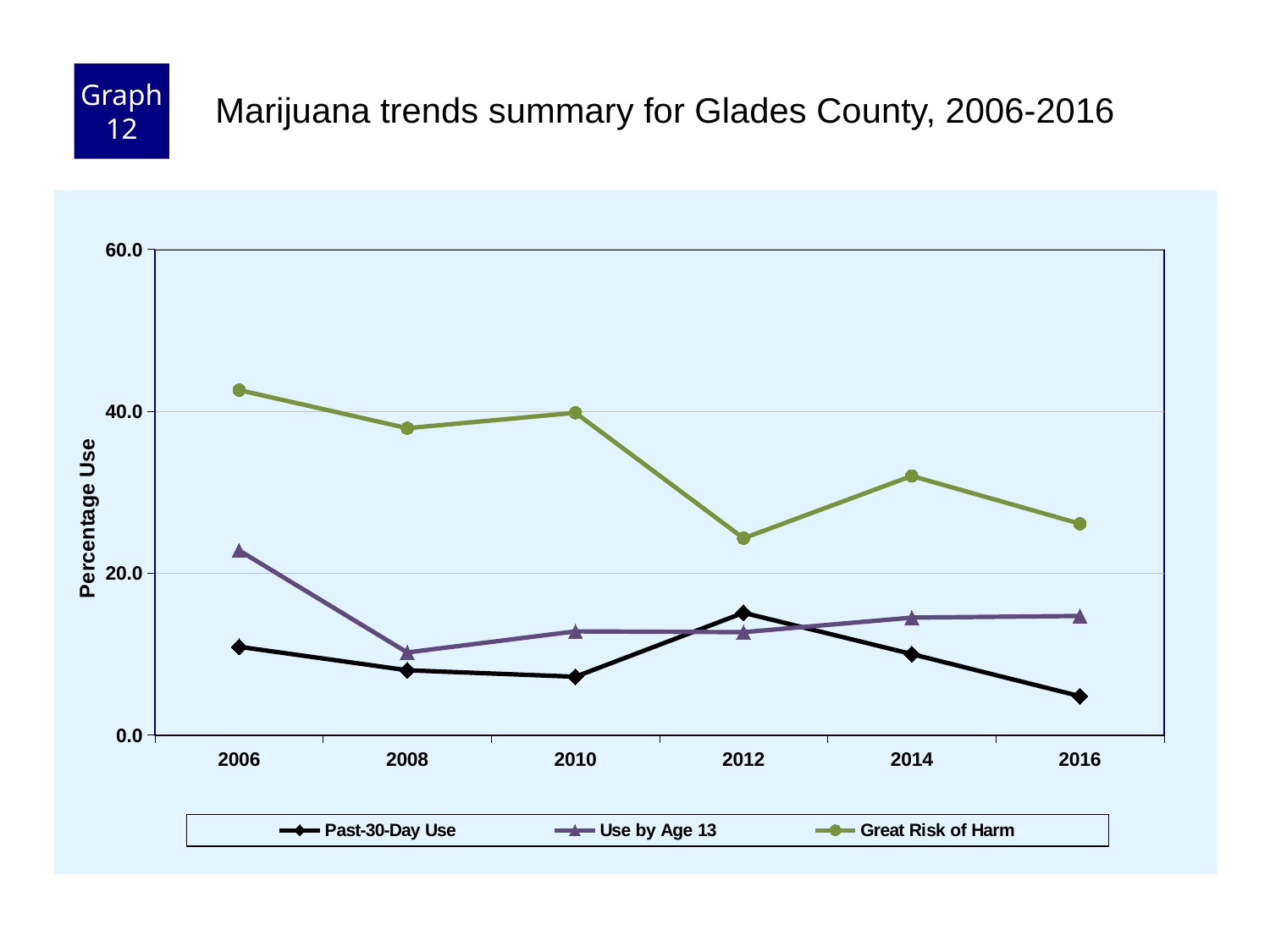
Is the Great Risk of Harm value for 2012 greater or less than 40.0? less Is the Use by Age 13 value for 2006 greater or less than 20.0? greater How many series does the legend list? 3 What is the label on the y axis? Percentage Use In which year is the Past-30-Day Use value lowest? 2016 Does the Great Risk of Harm series overall rise or fall from 2006 to 2016? Fall What kind of chart is shown on the slide? Line chart In 2006, which is larger: Use by Age 13 or Past-30-Day Use? Use by Age 13 Is the Great Risk of Harm value for 2006 greater or less than 40.0? greater In which year is the Great Risk of Harm value highest? 2006 How many years are plotted along the x axis? 6 In which year is the Past-30-Day Use value highest? 2012